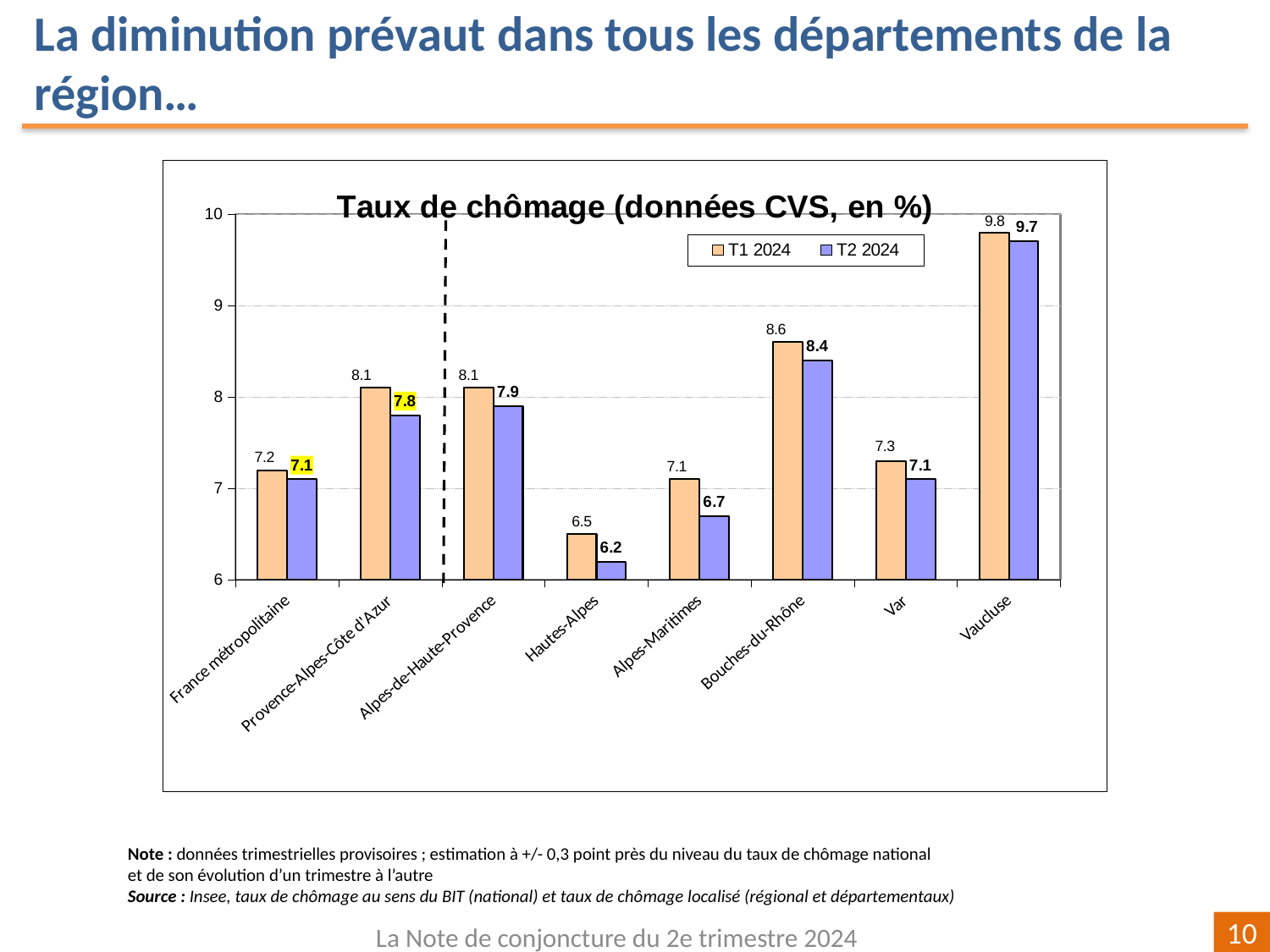
How many categories are shown on the x axis? 8 What is the title of the chart? Taux de chômage (données CVS, en %) Which is larger, the T2 2024 value for Var or the T2 2024 value for Provence-Alpes-Côte d'Azur? Provence-Alpes-Côte d'Azur What is the T1 2024 value for Bouches-du-Rhône? 8.6 How many series does the legend list? 2 Is the T1 2024 value for Vaucluse greater or less than 9? greater What kind of chart is shown? Bar chart What is the difference between the T1 2024 and T2 2024 values for Alpes-Maritimes? 0.4 What is the T2 2024 unemployment rate for Vaucluse? 9.7 What is the T2 2024 value for Hautes-Alpes? 6.2 Which category has the highest T2 2024 value? Vaucluse Which category has the lowest T1 2024 value? Hautes-Alpes